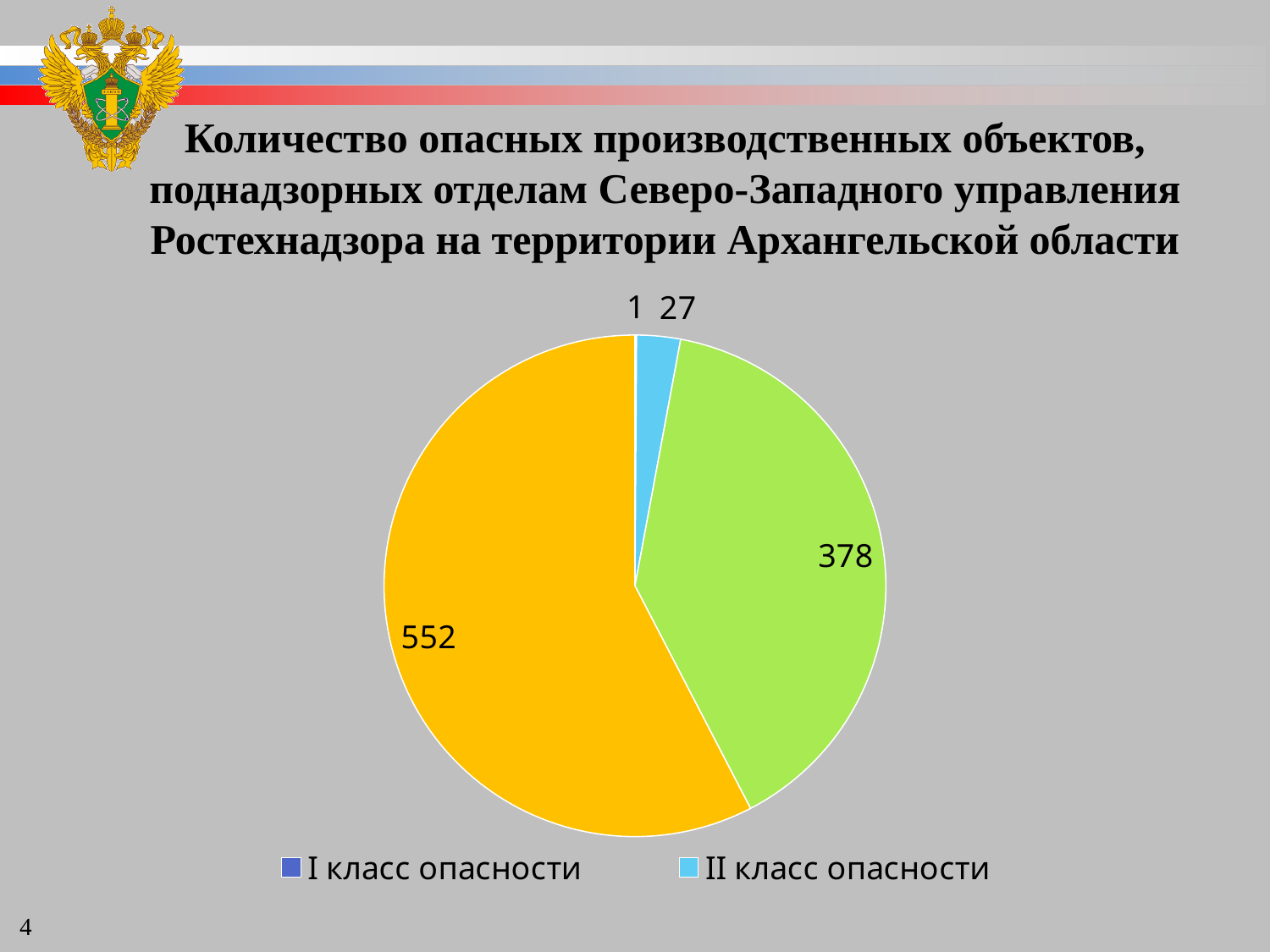
What is the value shown for II класс опасности? 27 What kind of chart is shown on the slide? pie chart What is the value shown for I класс опасности? 1 How many slices does the pie chart have? 4 What is the total of all the values shown on the pie chart? 958 What is the value of the largest slice in the pie chart? 552 Which legend category has the smallest slice? I класс опасности What is the difference between the values for II класс опасности and I класс опасности? 26 Which is larger, the value for I класс опасности or for II класс опасности? II класс опасности How many entries does the legend list? 2 What is the value of the green slice? 378 What colour is the slice for II класс опасности? light blue